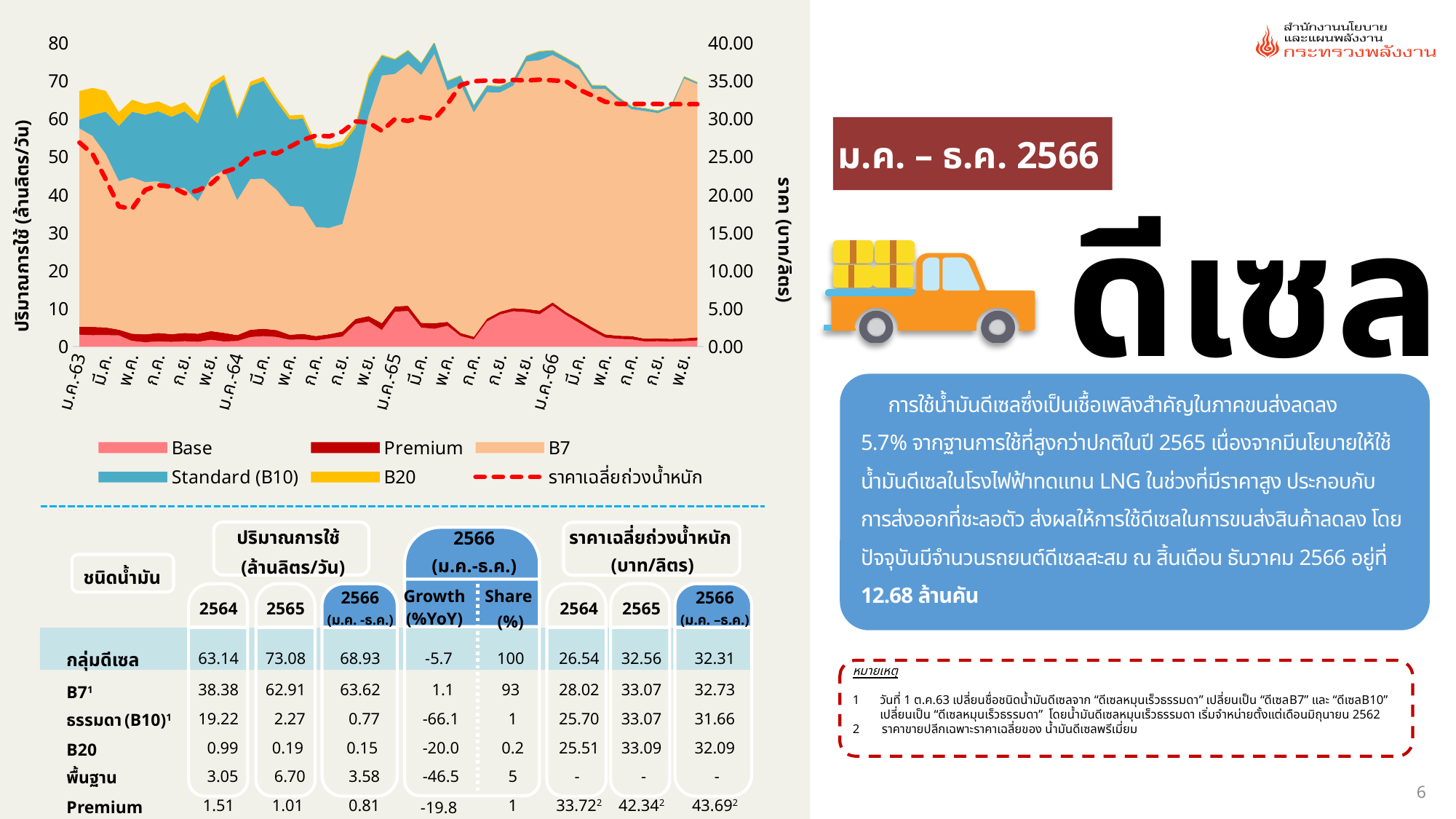
What is the title of the right-hand vertical axis of the chart? ราคา (บาท/ลิตร) What is the highest tick value shown on the left vertical axis of the chart? 80 Is the total stacked consumption at ม.ค.-63 greater or less than 50 on the left axis? greater Does the dashed ราคาเฉลี่ยถ่วงน้ำหนัก line generally rise or fall from พ.ค.-63 to ม.ค.-65? rise Is the total stacked consumption at ก.ย.-64 greater or less than 40 on the left axis? greater How many series does the chart legend list? 6 What is the highest tick value shown on the right vertical axis of the chart? 40.00 What kind of chart is shown on the left of the slide? stacked area chart with a line Is the value of the dashed ราคาเฉลี่ยถ่วงน้ำหนัก line at พ.ค.-63 greater or less than 20.00 on the right axis? less Is the Standard (B10) band thicker at ม.ค.-63 or at พ.ย.-66? ม.ค.-63 Which legend entry is drawn as a red dashed line? ราคาเฉลี่ยถ่วงน้ำหนัก How many tick labels are shown along the x axis of the chart? 24